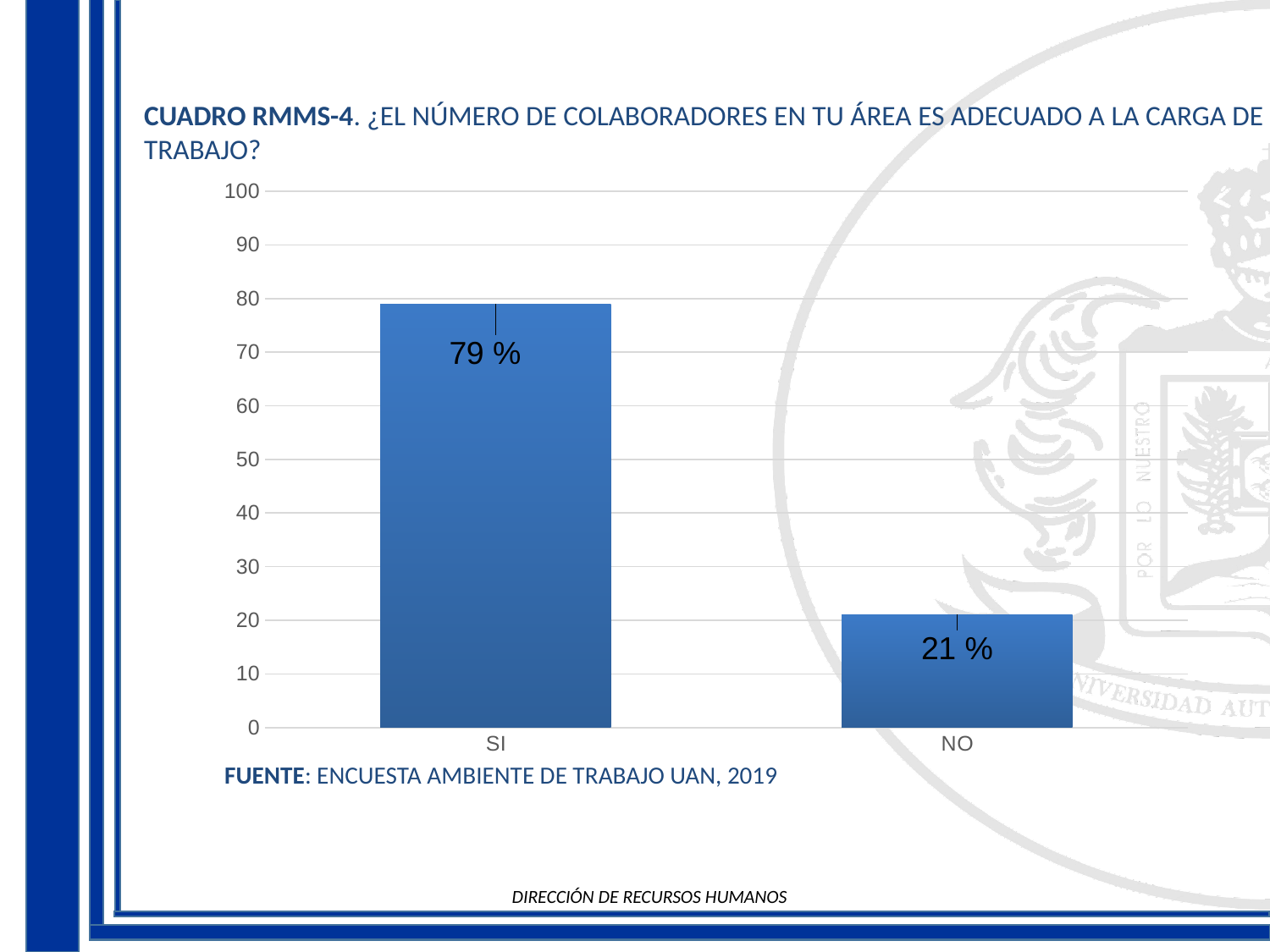
Which category has the highest value? SI Is the value for SI greater or less than 70? greater What is the highest value shown on the vertical axis? 100 What kind of chart is shown on the slide? bar chart What is the value for SI? 79 % Which category has the lowest value? NO What is the difference between the values for SI and NO? 58 % What is the value for NO? 21 % How many categories are shown on the x axis? 2 What is the source cited below the chart? ENCUESTA AMBIENTE DE TRABAJO UAN, 2019 Which is larger, the value for SI or the value for NO? SI Is the value for NO greater or less than 30? less